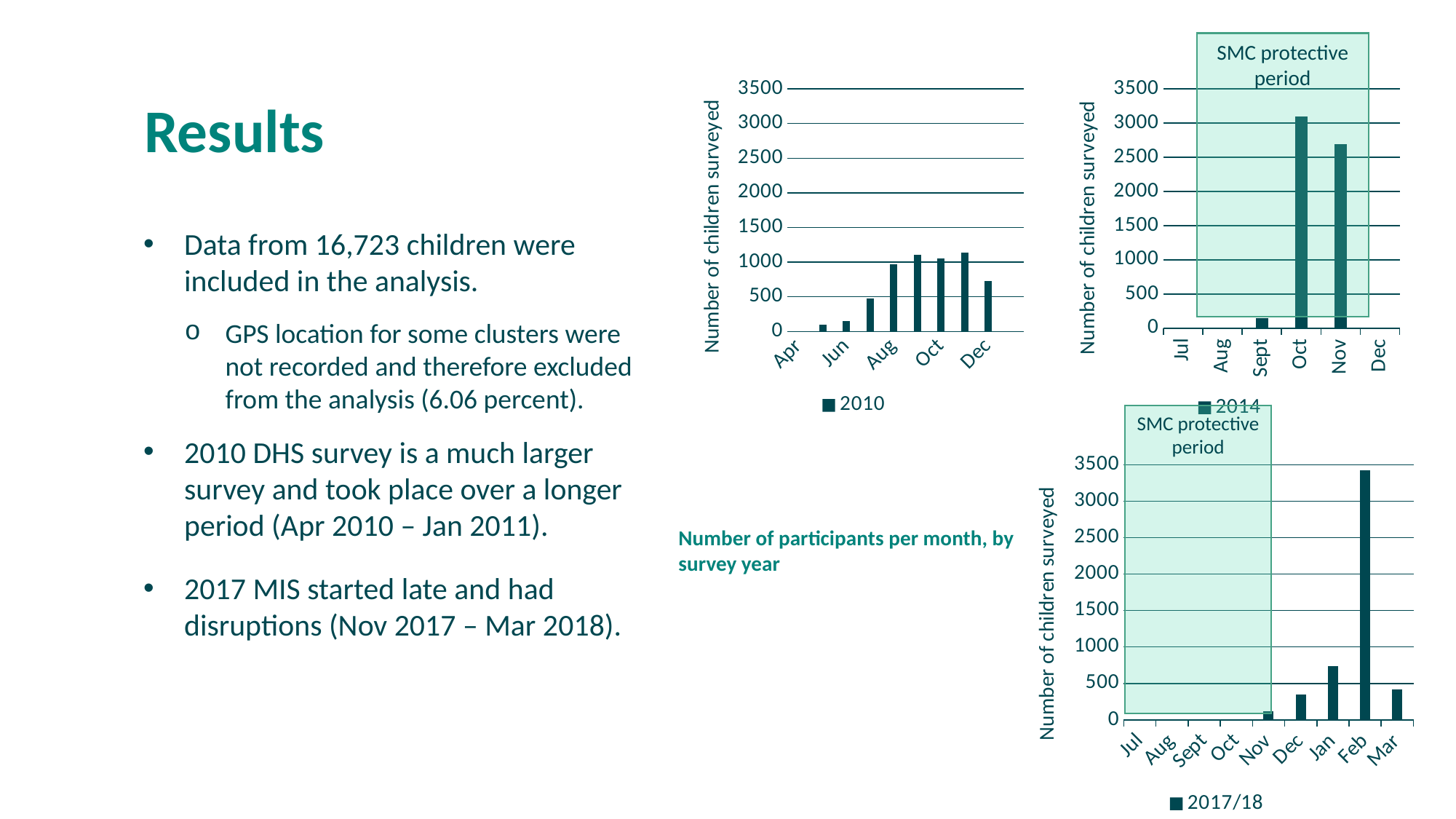
In the chart with the legend entry 2017/18, is the value for Feb greater or less than 3000? greater How many months are shown on the x axis of the chart with the legend entry 2017/18? 9 In the chart with the legend entry 2014, is the value for Nov greater or less than 3000? less How many series does the legend of the chart with the legend entry 2014 list? 1 In the chart with the legend entry 2017/18, which month has the larger value, Dec or Jan? Jan In the chart with the legend entry 2017/18, is the value for Jan greater or less than 1000? less In the chart with the legend entry 2014, which month has the highest number of children surveyed? Oct In the chart with the legend entry 2017/18, which month has the highest number of children surveyed? Feb In the chart with the legend entry 2014, which month has the larger value, Oct or Nov? Oct What kind of chart is the chart with the legend entry 2010? bar chart What is the label of the shaded region in the chart with the legend entry 2014? SMC protective period